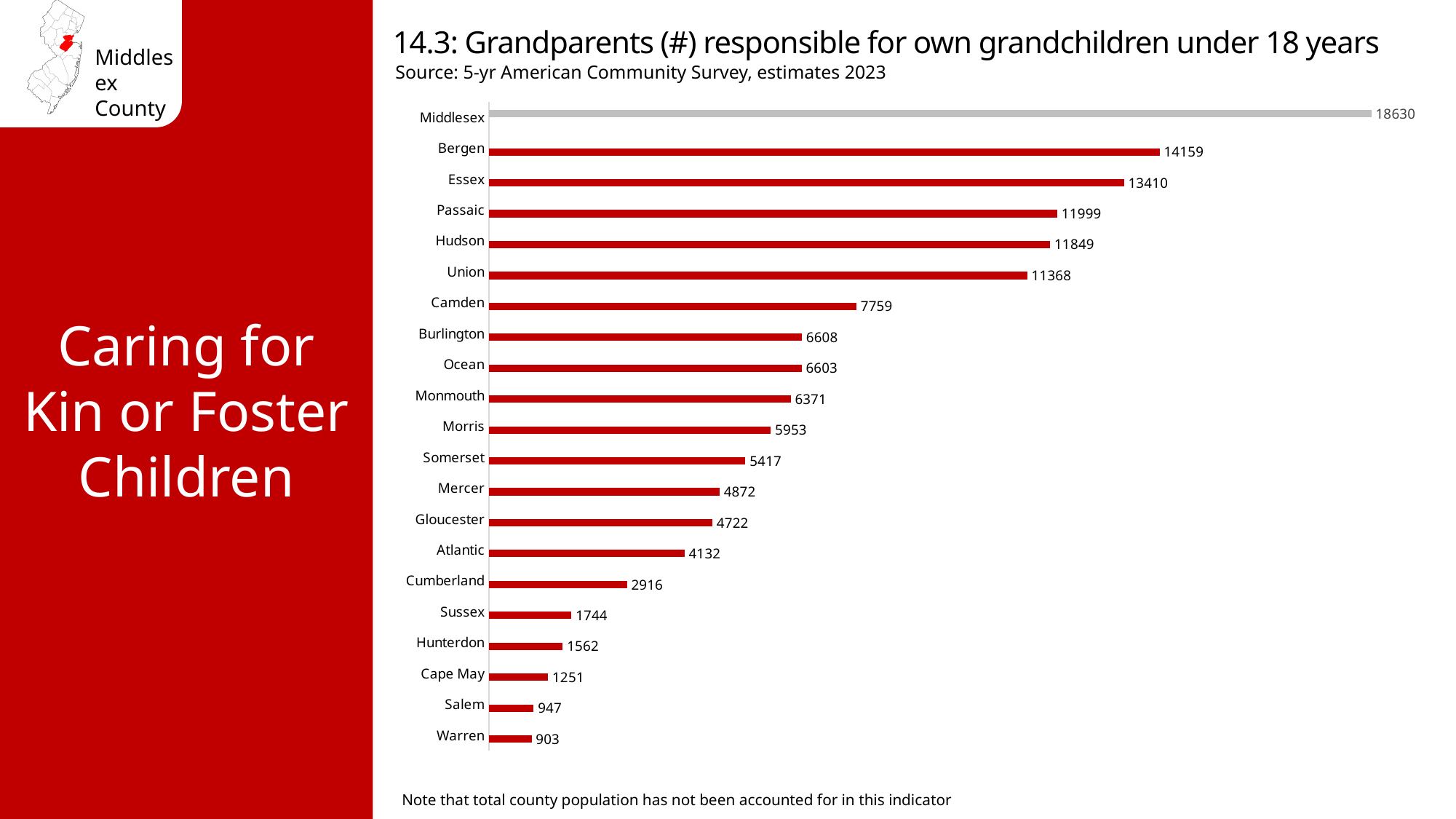
What is the difference between the values for Middlesex and Union? 7262 How many counties are shown in the chart? 21 What is the difference between the values for Bergen and Essex? 749 Which county has the highest value? Middlesex What is the value for Cape May? 1251 Which is larger, the value for Passaic or the value for Hudson? Passaic What is the value for Camden? 7759 What is the value for Middlesex? 18630 Which county's bar is shown in grey rather than red? Middlesex What kind of chart is shown on the slide? Bar chart Which county has the lowest value? Warren Which is larger, the value for Mercer or the value for Atlantic? Mercer